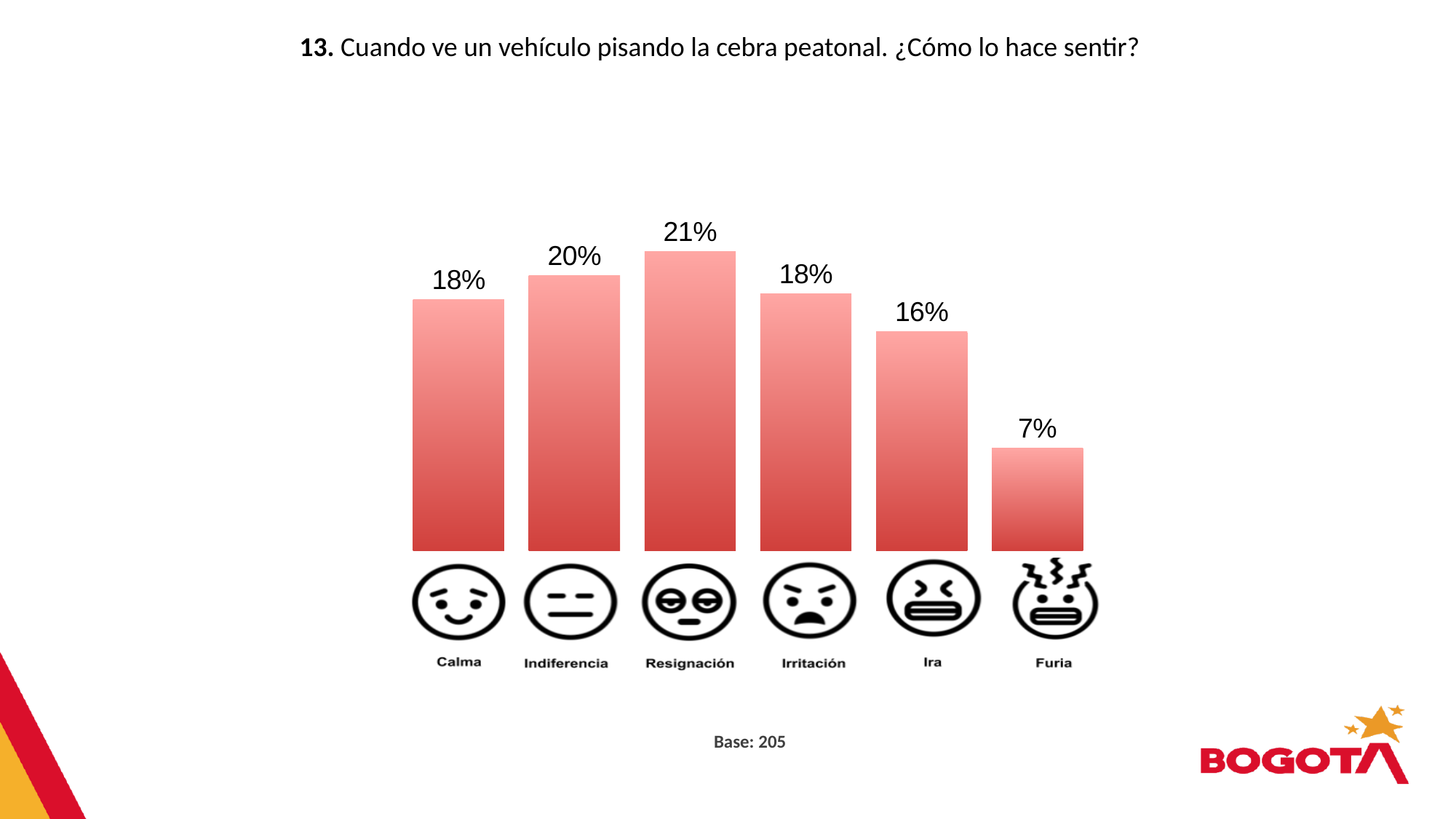
Which category has the lowest value? Furia What type of chart is shown on the slide? Bar chart What is the value shown for Resignación? 21% What is the difference between Indiferencia and Ira? 4% What percentage of respondents answered Calma? 18% What is the value for Ira? 16% What is the base (number of respondents) stated below the chart? 205 What percentage is shown for Furia? 7% Which category has the highest value? Resignación What is the difference between the values for Resignación and Furia? 14% How many categories are shown in the chart? 6 Which is larger, the value for Indiferencia or the value for Ira? Indiferencia